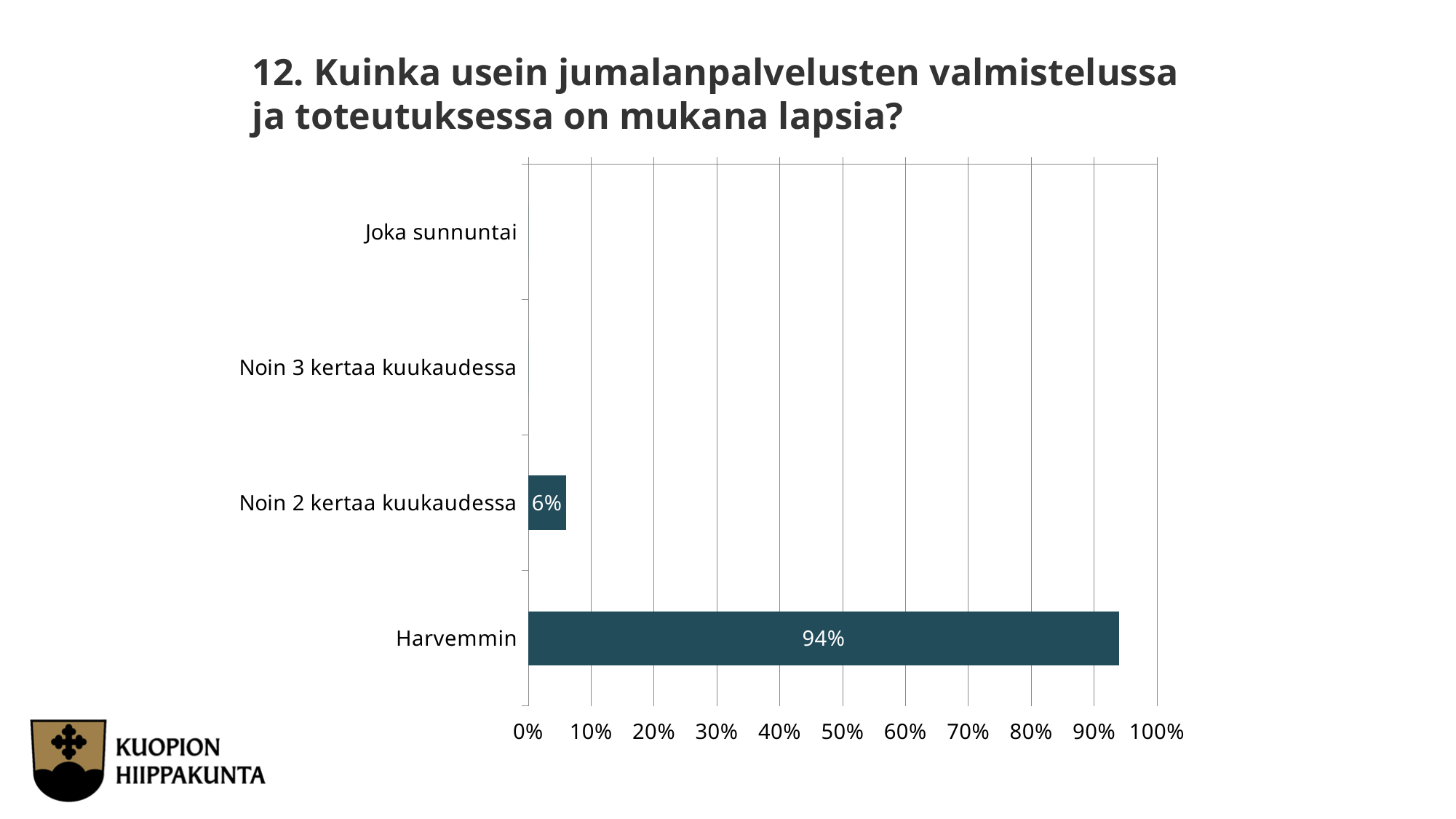
Is the value for Harvemmin greater or less than 90%? greater Which category has the highest value? Harvemmin How many categories are shown on the y axis of the chart? 4 Is the value for Noin 2 kertaa kuukaudessa greater or less than 10%? less What is the value for Noin 2 kertaa kuukaudessa? 6% Which is larger, the value for Harvemmin or the value for Noin 2 kertaa kuukaudessa? Harvemmin What is the value for Harvemmin? 94% What is the difference between the values for Harvemmin and Noin 2 kertaa kuukaudessa? 88% What kind of chart is shown on the slide? bar chart What is the title of the chart? 12. Kuinka usein jumalanpalvelusten valmistelussa ja toteutuksessa on mukana lapsia? What is the maximum value shown on the x axis? 100%